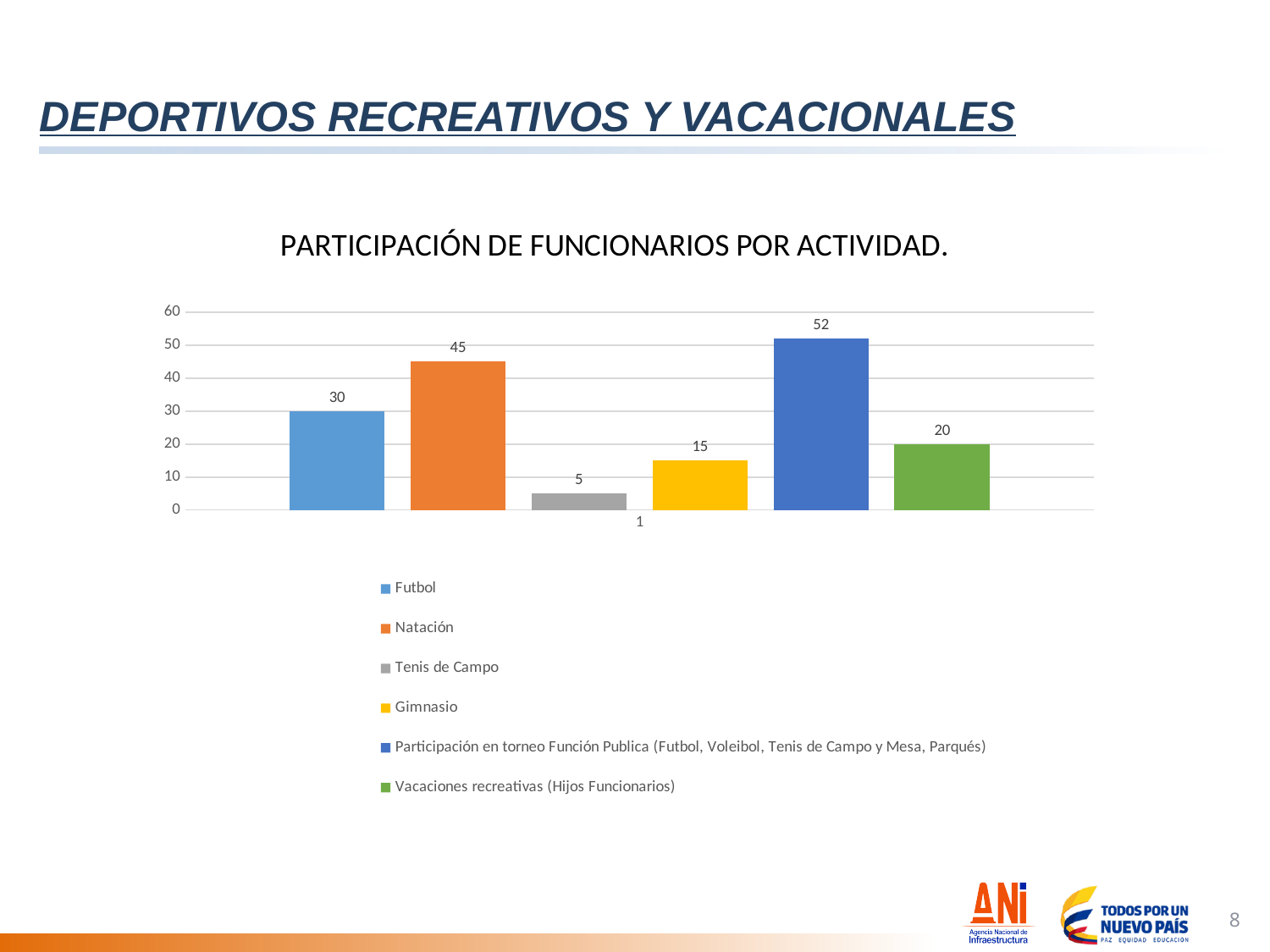
Which series has the highest value? Participación en torneo Función Publica (Futbol, Voleibol, Tenis de Campo y Mesa, Parqués) Which series has the lowest value? Tenis de Campo What is the value for Tenis de Campo? 5 What is the value for Futbol? 30 What is the value for Vacaciones recreativas (Hijos Funcionarios)? 20 Which is larger, the value for Gimnasio or the value for Vacaciones recreativas (Hijos Funcionarios)? Vacaciones recreativas (Hijos Funcionarios) What is the title of the chart? PARTICIPACIÓN DE FUNCIONARIOS POR ACTIVIDAD. How many series does the legend list? 6 What is the difference between the values for Natación and Futbol? 15 What is the value for Gimnasio? 15 What is the value for Natación? 45 What kind of chart is shown on the slide? Bar chart